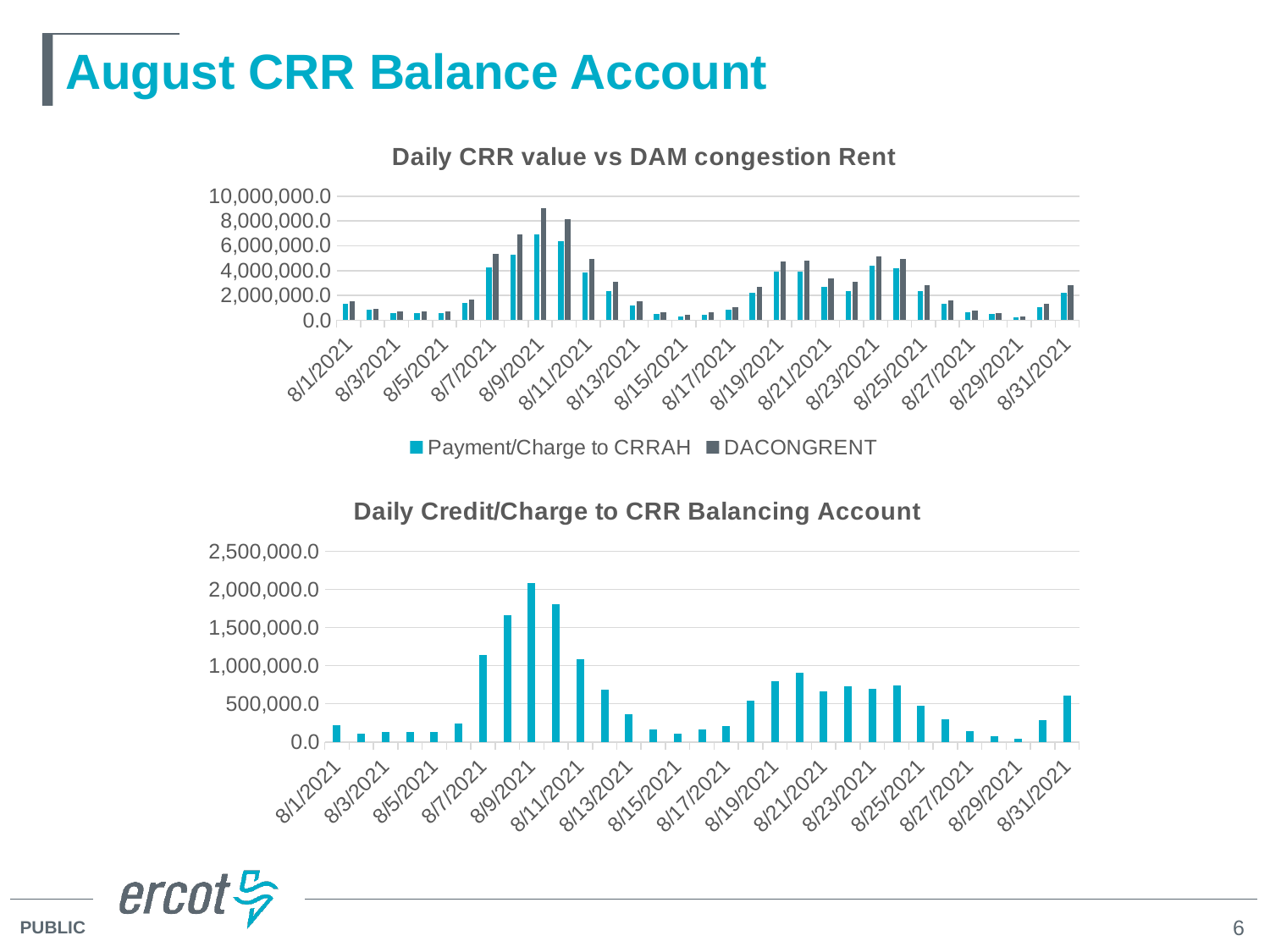
What type of chart is the top chart, 'Daily CRR value vs DAM congestion Rent'? Bar chart In the bottom chart, 'Daily Credit/Charge to CRR Balancing Account', is the value for 8/13/2021 greater or less than 500,000.0? less In the top chart, 'Daily CRR value vs DAM congestion Rent', on which date is DACONGRENT highest? 8/9/2021 In the top chart, 'Daily CRR value vs DAM congestion Rent', is the DACONGRENT value for 8/9/2021 greater or less than 8,000,000.0? greater How many series does the legend of the top chart, 'Daily CRR value vs DAM congestion Rent', list? 2 In the bottom chart, 'Daily Credit/Charge to CRR Balancing Account', do the values rise or fall from 8/7/2021 to 8/9/2021? rise In the bottom chart, 'Daily Credit/Charge to CRR Balancing Account', which date has the larger value, 8/9/2021 or 8/21/2021? 8/9/2021 In the bottom chart, 'Daily Credit/Charge to CRR Balancing Account', is the value for 8/9/2021 greater or less than 2,000,000.0? greater In the bottom chart, 'Daily Credit/Charge to CRR Balancing Account', on which date is the value highest? 8/9/2021 In the top chart, 'Daily CRR value vs DAM congestion Rent', which series is larger on 8/9/2021, Payment/Charge to CRRAH or DACONGRENT? DACONGRENT